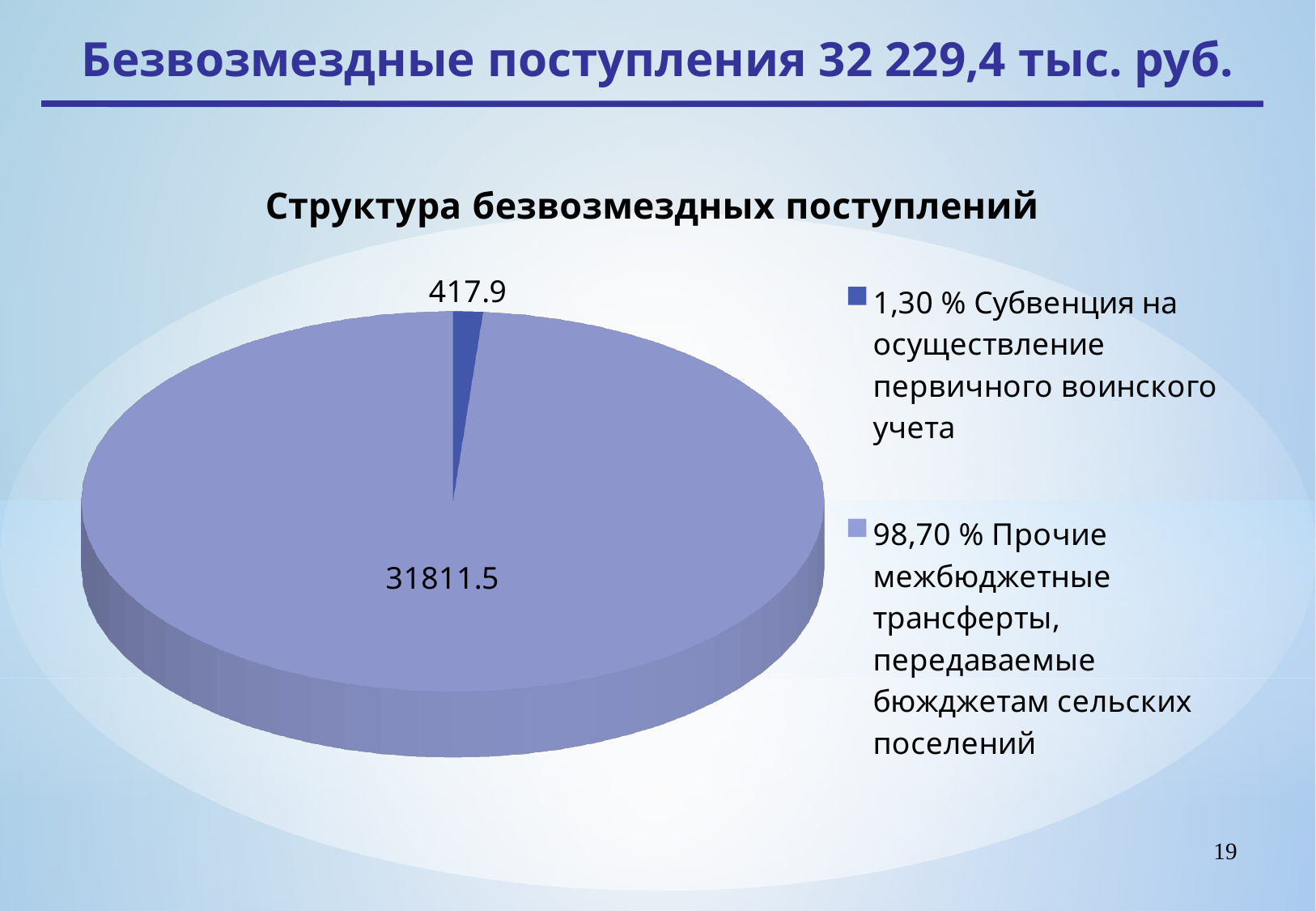
Which category has the smallest slice? Субвенция на осуществление первичного воинского учета What is the value of the slice for Прочие межбюджетные трансферты, передаваемые бюджетам сельских поселений? 31811.5 What is the difference between the two slice values, 31811.5 and 417.9? 31393.6 What kind of chart is shown on the slide? pie chart What is the title of the chart? Структура безвозмездных поступлений What share of the pie does the legend give for Субвенция на осуществление первичного воинского учета? 1,30 % Which is larger: the slice for Субвенция на осуществление первичного воинского учета or the slice for Прочие межбюджетные трансферты? Прочие межбюджетные трансферты What is the total of the two slice values, 417.9 and 31811.5? 32229.4 Which category has the largest slice? Прочие межбюджетные трансферты, передаваемые бюджетам сельских поселений What is the value of the slice for Субвенция на осуществление первичного воинского учета? 417.9 What share of the pie does the legend give for Прочие межбюджетные трансферты, передаваемые бюджетам сельских поселений? 98,70 % How many slices does the pie chart have? 2